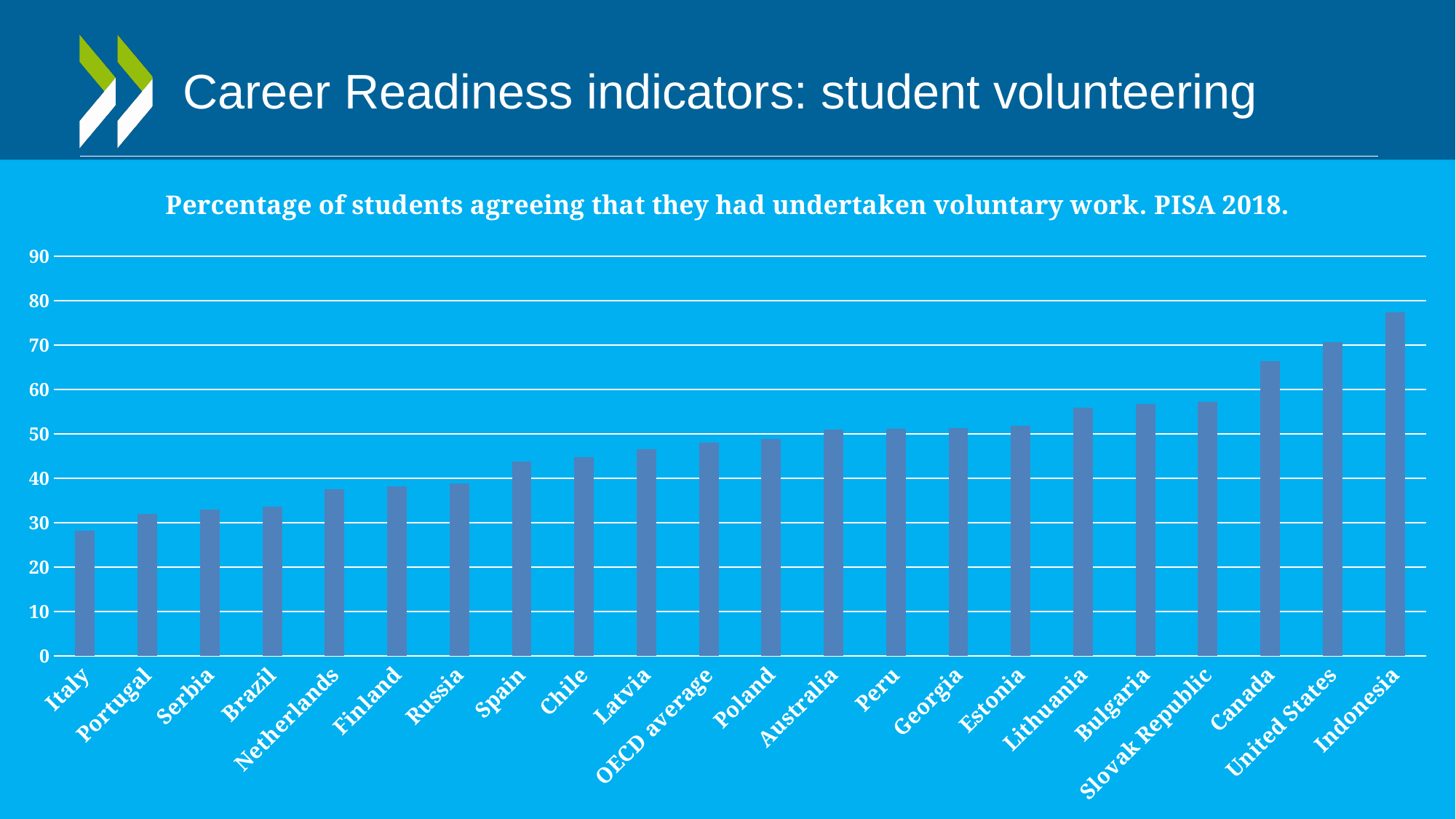
Is the value for Canada greater or less than 60? greater What kind of chart is shown on the slide? bar chart Which country has the lowest percentage of students agreeing that they had undertaken voluntary work? Italy What is the title of the chart? Percentage of students agreeing that they had undertaken voluntary work. PISA 2018. Is the value for Italy greater or less than 30? less Do the values rise or fall moving from left to right along the x axis? rise Is the value for Lithuania greater or less than 50? greater Which country has the highest percentage of students agreeing that they had undertaken voluntary work? Indonesia How many categories are plotted on the chart? 22 Which has a larger value, Canada or Spain? Canada